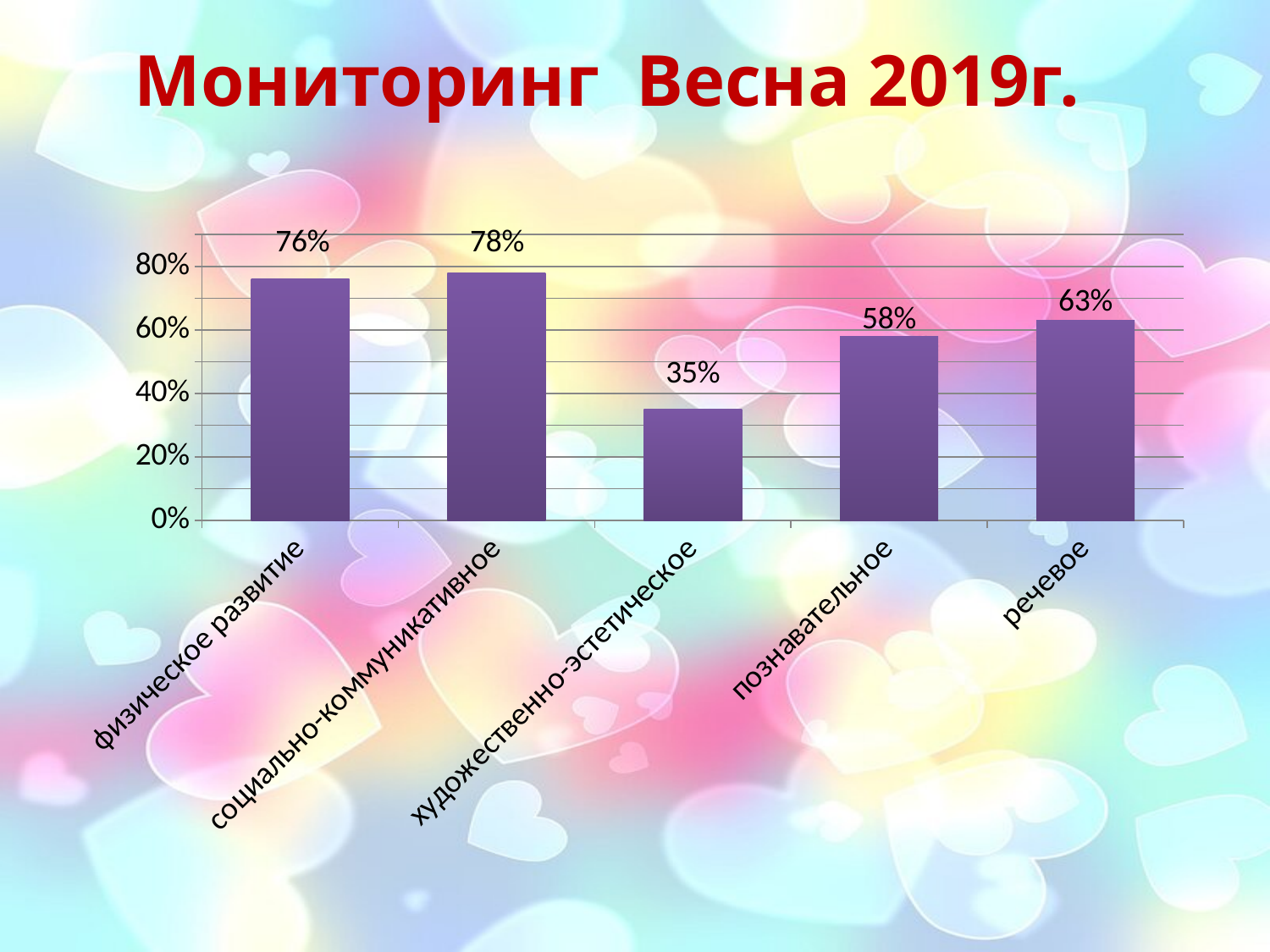
Which category has the lowest value? художественно-эстетическое How many categories are shown in the chart? 5 What is the value for художественно-эстетическое? 35% What is the title of the slide? Мониторинг Весна 2019г. What kind of chart is shown on the slide? bar chart What is the value for познавательное? 58% Which category has the highest value? социально-коммуникативное Which is larger, the value for речевое or the value for познавательное? речевое What is the value for речевое? 63% What is the value for социально-коммуникативное? 78% What is the difference between the values for социально-коммуникативное and художественно-эстетическое? 43% What is the value for физическое развитие? 76%